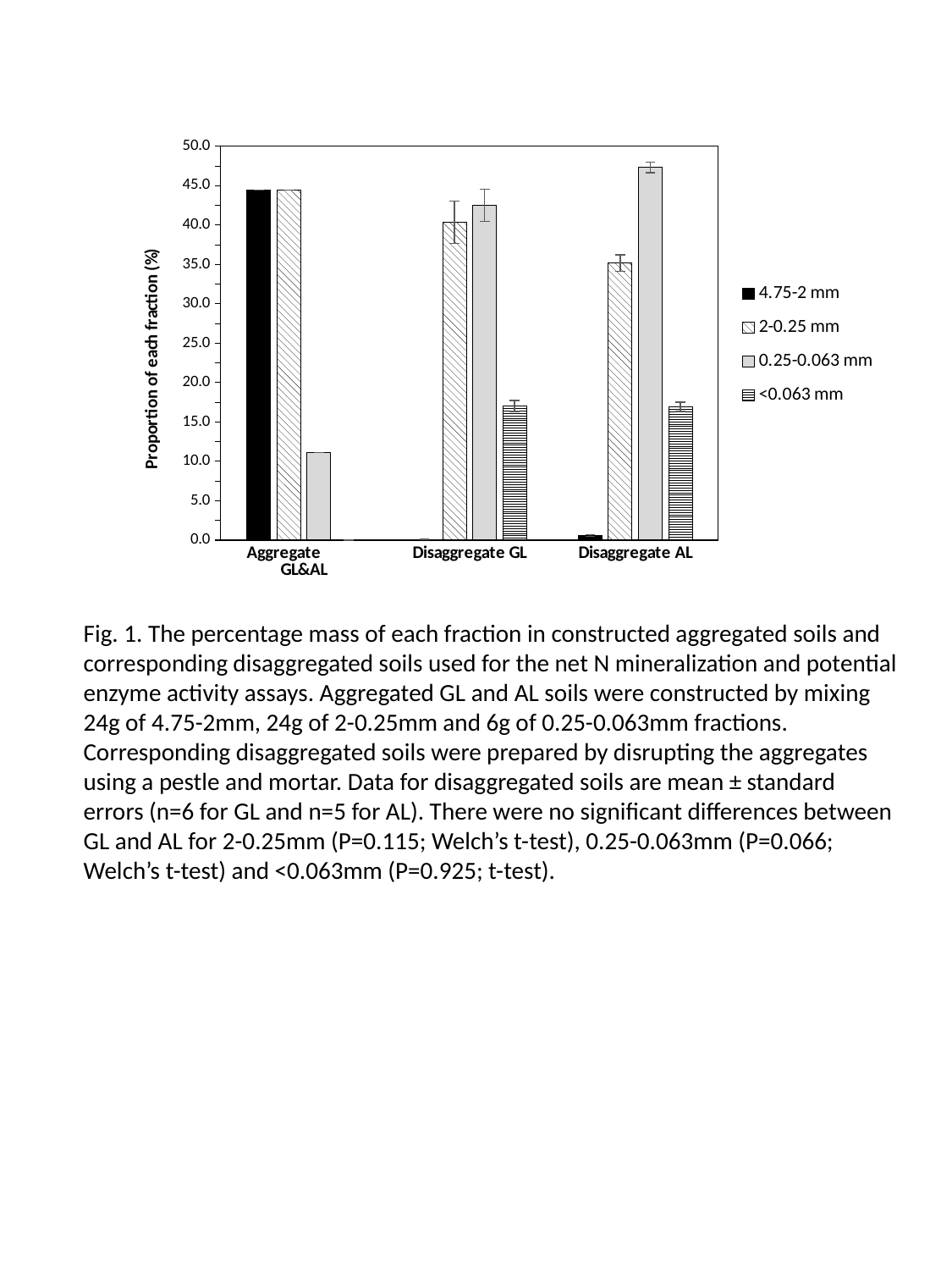
Is the value for 4.75-2 mm in Aggregate GL&AL greater or less than 40.0? greater Is the value for 2-0.25 mm in Disaggregate AL greater or less than 30.0? greater Which is larger for the 2-0.25 mm series: Disaggregate GL or Disaggregate AL? Disaggregate GL How many categories are shown on the x axis? 3 In Disaggregate AL, which is larger: 2-0.25 mm or 0.25-0.063 mm? 0.25-0.063 mm What kind of chart is shown on the slide? bar chart Is the value for 0.25-0.063 mm in Aggregate GL&AL greater or less than 15.0? less What is the title of the y axis? Proportion of each fraction (%) How many series does the legend list? 4 Which category has the highest value for the 0.25-0.063 mm series? Disaggregate AL